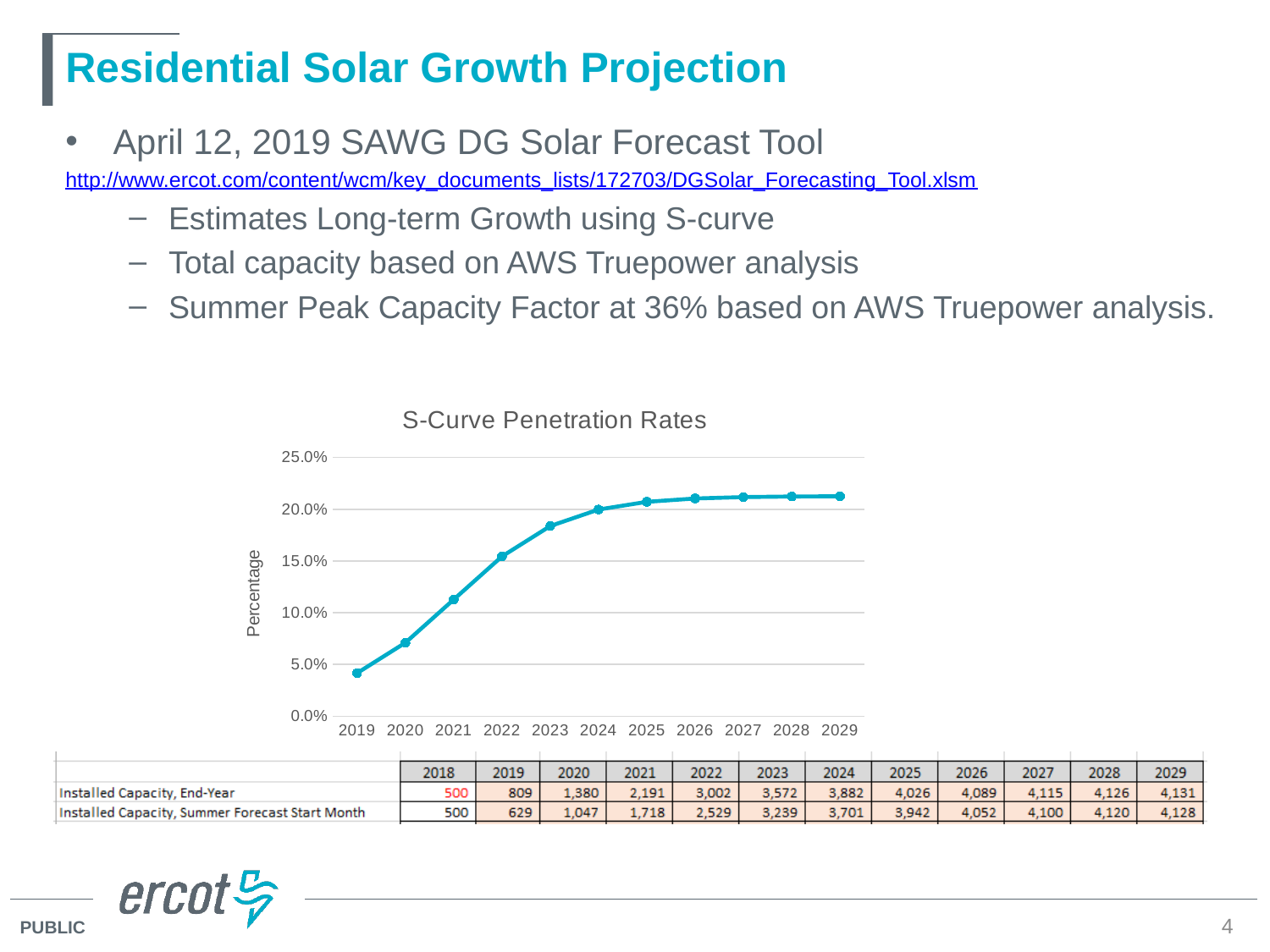
Do the penetration rates rise or fall from 2019 to 2029 in the S-Curve Penetration Rates chart? rise Which year has the lowest penetration rate in the S-Curve Penetration Rates chart? 2019 Which year has the larger penetration rate, 2021 or 2023? 2023 What is the label on the vertical axis of the S-Curve Penetration Rates chart? Percentage How many years are plotted on the x axis of the S-Curve Penetration Rates chart? 11 Is the penetration rate for 2023 greater or less than 20.0%? less Is the penetration rate for 2029 greater or less than 25.0%? less Is the penetration rate for 2019 greater or less than 5.0%? less What kind of chart is the S-Curve Penetration Rates chart? line chart What is the title of the chart on the slide? S-Curve Penetration Rates